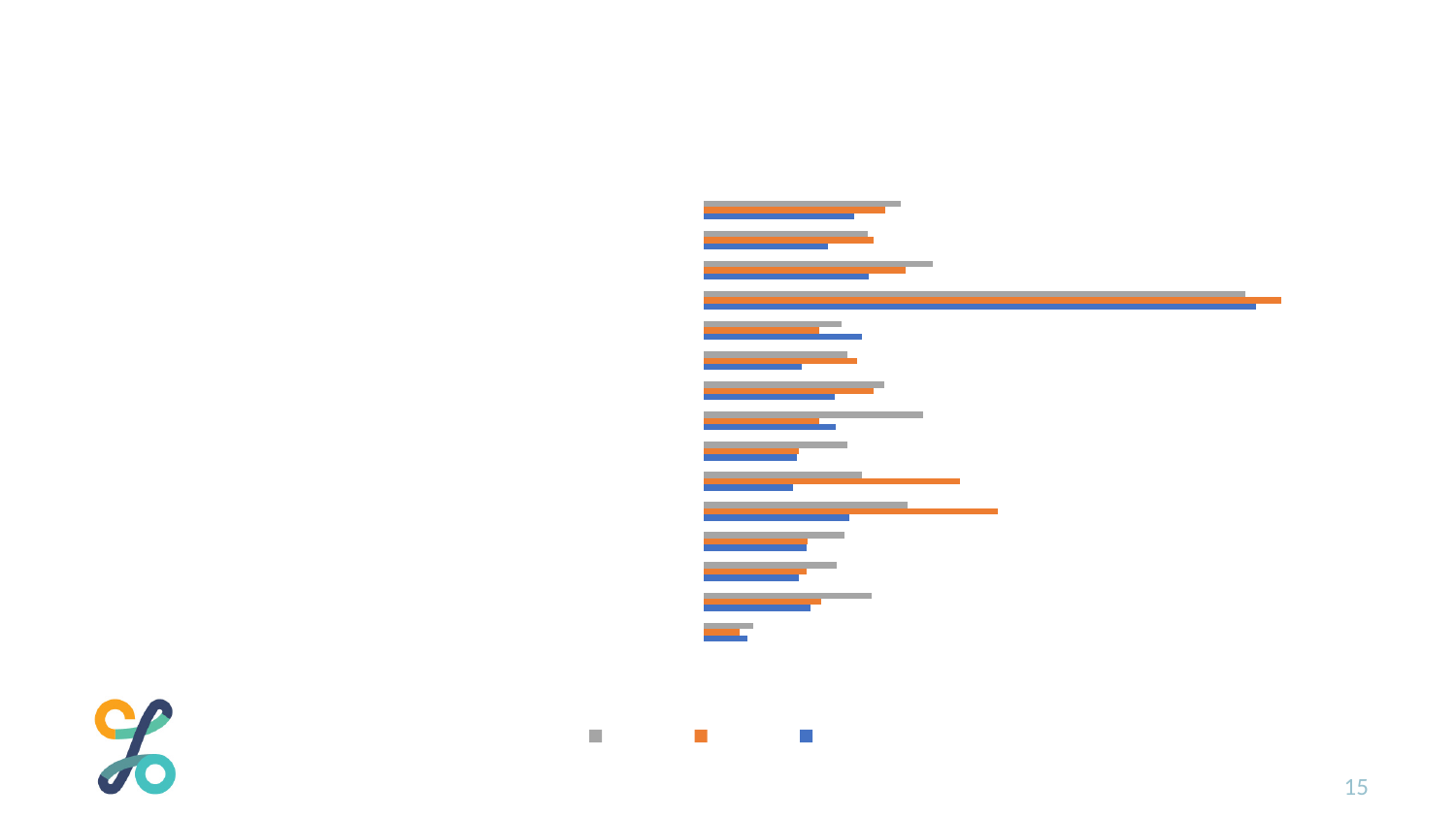
Counting from the top, which group of bars is the shortest overall? the last (fifteenth) group In the fourth group from the top, which series has the longest bar? orange How many series does the legend list? 3 Are the bars in the chart horizontal or vertical? horizontal What colours are the three series in the chart? grey, orange and blue Counting from the top, which group of bars extends furthest to the right? the fourth group How many groups of bars (categories) are plotted in the chart? 15 What kind of chart is shown on the slide? bar chart